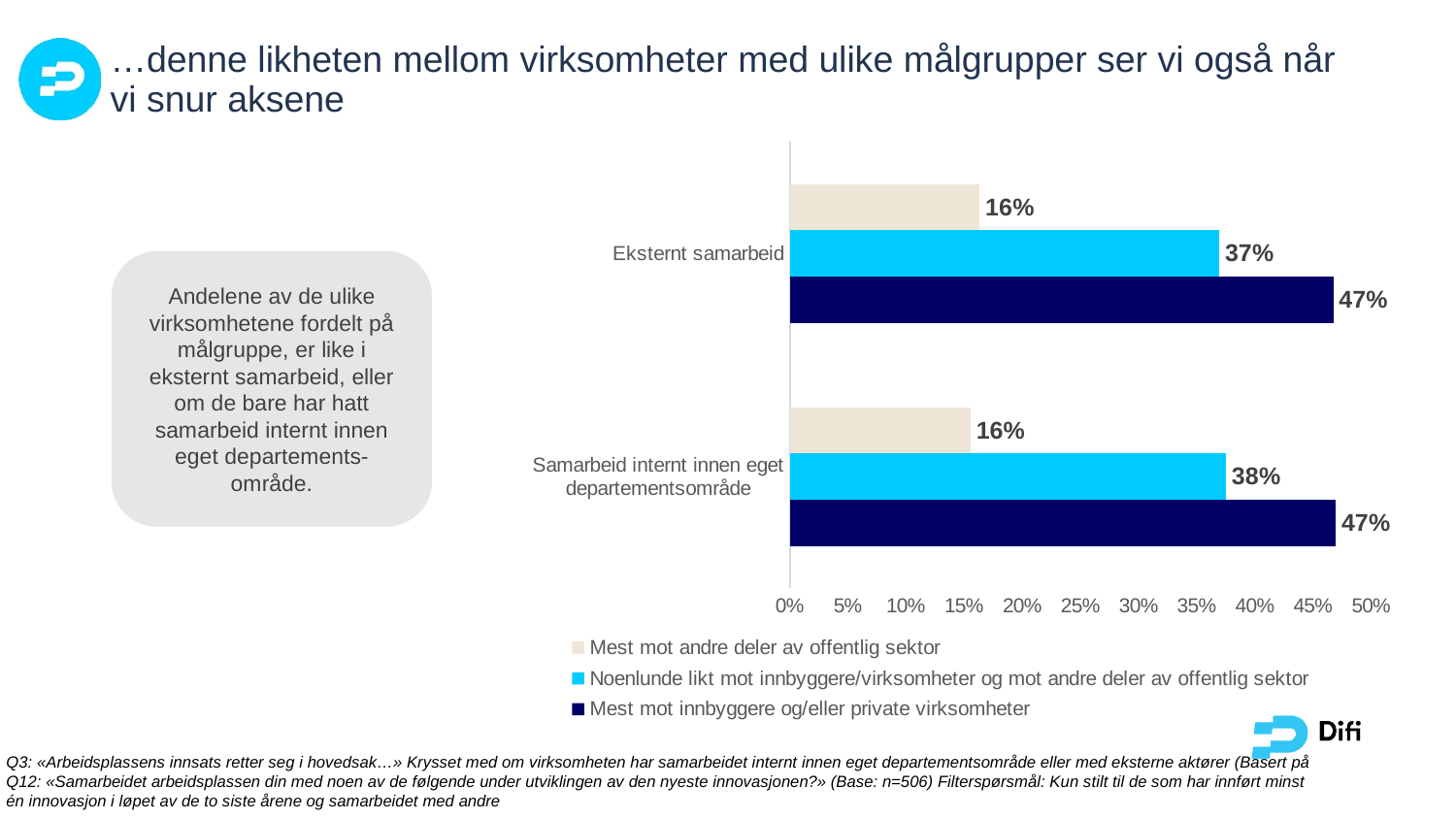
What kind of chart is shown on the slide? bar chart Which series has the lowest value in the 'Samarbeid internt innen eget departementsområde' category? Mest mot andre deler av offentlig sektor What is the value for 'Noenlunde likt mot innbyggere/virksomheter og mot andre deler av offentlig sektor' in the 'Eksternt samarbeid' category? 37% What is the value for 'Mest mot andre deler av offentlig sektor' in the 'Samarbeid internt innen eget departementsområde' category? 16% How many categories are shown on the chart? 2 How many series does the legend list? 3 What is the difference between 'Mest mot innbyggere og/eller private virksomheter' and 'Mest mot andre deler av offentlig sektor' in the 'Eksternt samarbeid' category? 31% Which is larger: 'Noenlunde likt mot innbyggere/virksomheter og mot andre deler av offentlig sektor' for 'Eksternt samarbeid' or for 'Samarbeid internt innen eget departementsområde'? Samarbeid internt innen eget departementsområde What is the value for 'Noenlunde likt mot innbyggere/virksomheter og mot andre deler av offentlig sektor' in the 'Samarbeid internt innen eget departementsområde' category? 38% Which series has the highest value in the 'Eksternt samarbeid' category? Mest mot innbyggere og/eller private virksomheter What is the value for 'Mest mot innbyggere og/eller private virksomheter' in the 'Eksternt samarbeid' category? 47% What colour represents 'Mest mot innbyggere og/eller private virksomheter' in the chart? dark blue